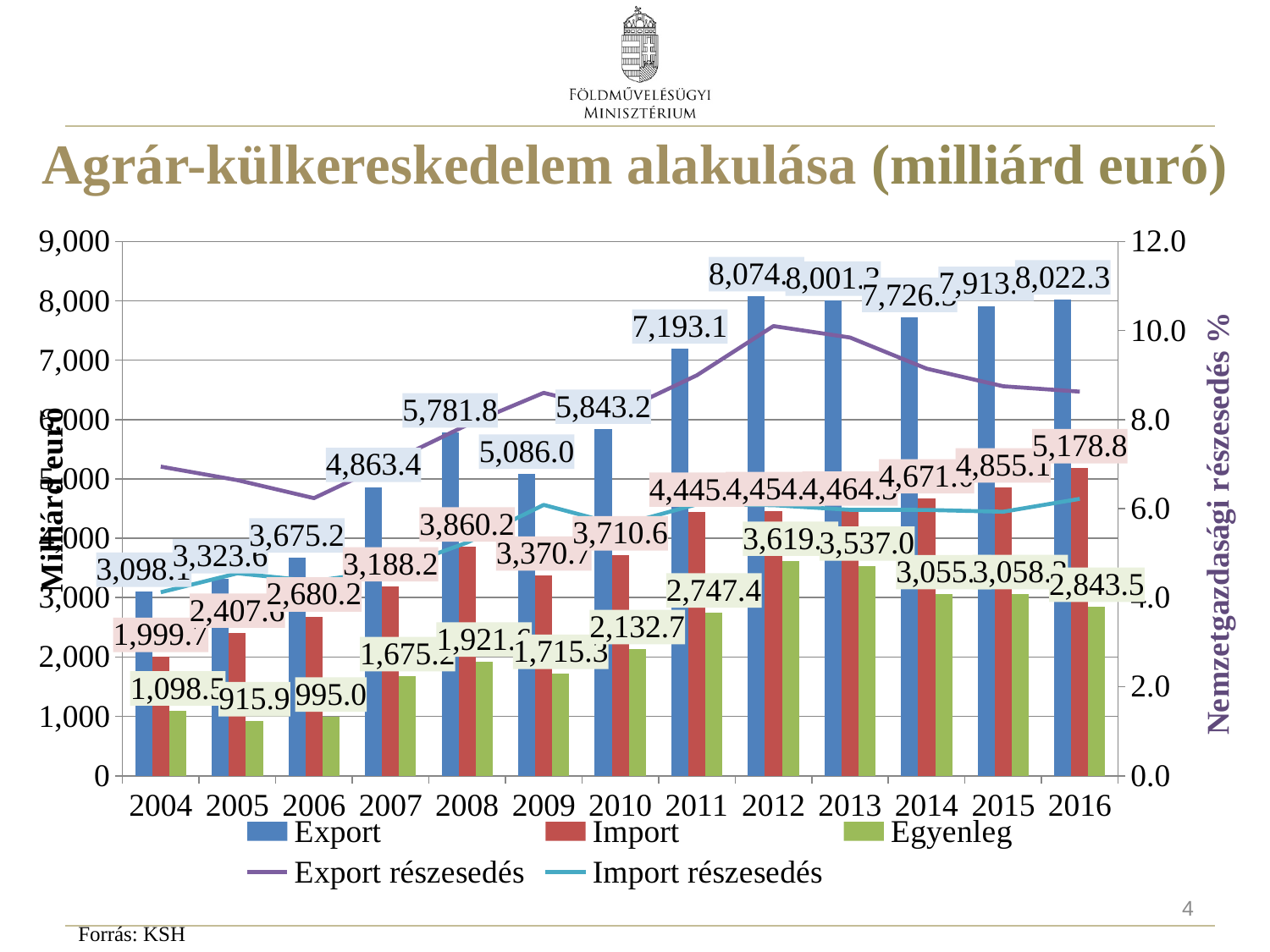
What is the difference between the Export and Import values for 2016? 2,843.5 Which year has the lowest Export value? 2004 What is the Import value for 2008? 3,860.2 How many years are shown on the x axis? 13 Which year has the lowest Egyenleg value? 2005 Is the Import value for 2010 greater or less than 3,000? greater How many series does the legend list? 5 What is the Egyenleg value for 2004? 1,098.5 What is the Export value for 2016? 8,022.3 What is the Import value for 2016? 5,178.8 What is the Export value for 2011? 7,193.1 Which is larger, the Export value for 2008 or the Export value for 2009? Export 2008